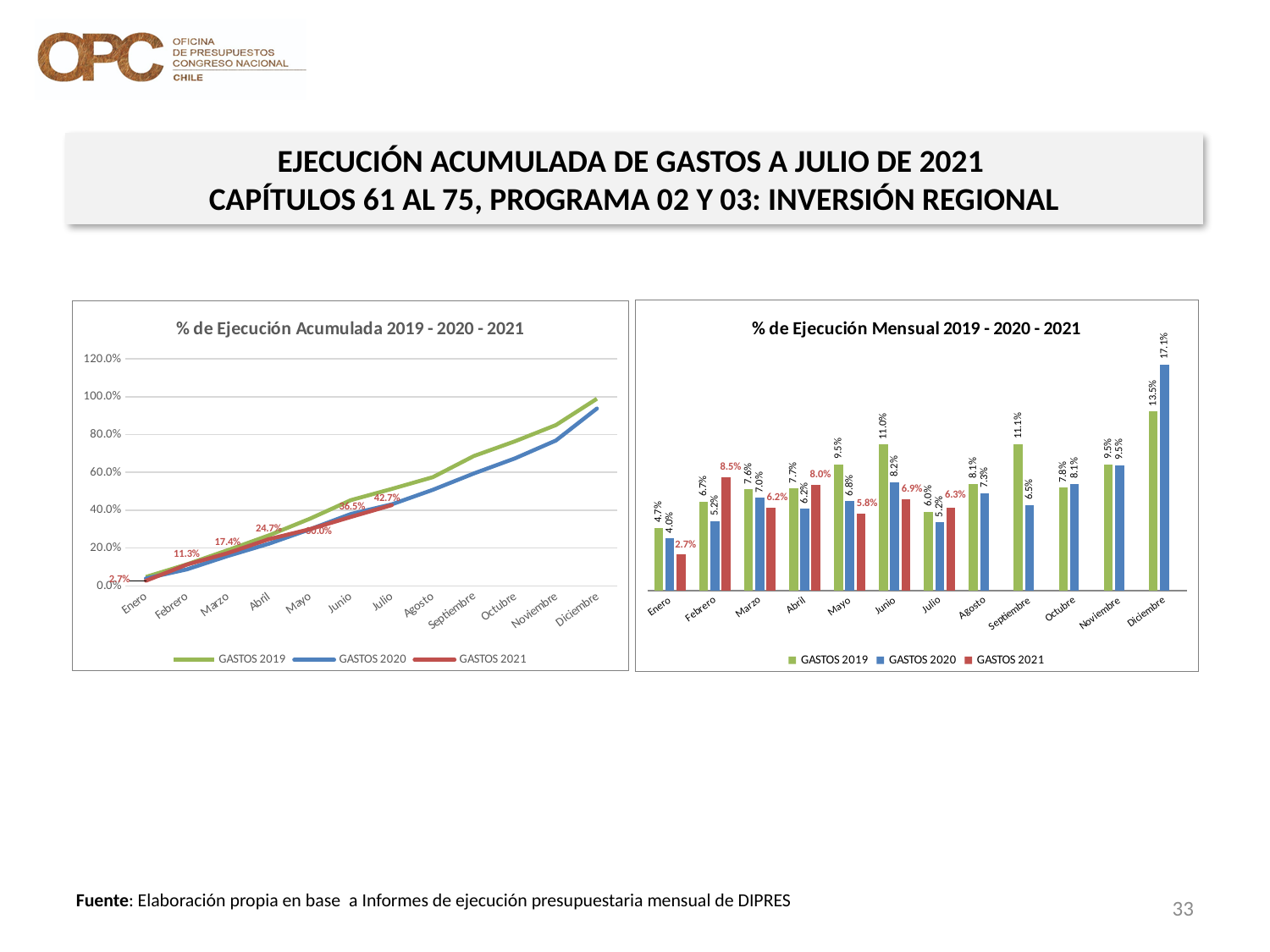
In the '% de Ejecución Acumulada 2019 - 2020 - 2021' chart, what is the value for GASTOS 2021 in Julio? 42.7% In the '% de Ejecución Acumulada 2019 - 2020 - 2021' chart, what kind of chart is shown? Line chart In the '% de Ejecución Acumulada 2019 - 2020 - 2021' chart, is the value for GASTOS 2019 in Diciembre greater or less than 80.0%? greater In the '% de Ejecución Acumulada 2019 - 2020 - 2021' chart, do the GASTOS 2021 values rise or fall from Enero to Julio? rise In the '% de Ejecución Mensual 2019 - 2020 - 2021' chart, what is the value for GASTOS 2020 in Diciembre? 17.1% In the '% de Ejecución Acumulada 2019 - 2020 - 2021' chart, what is the value for GASTOS 2021 in Marzo? 17.4% In the '% de Ejecución Mensual 2019 - 2020 - 2021' chart, which month has the highest value for GASTOS 2021? Febrero In the '% de Ejecución Mensual 2019 - 2020 - 2021' chart, which is larger in Abril: GASTOS 2021 or GASTOS 2020? GASTOS 2021 In the '% de Ejecución Mensual 2019 - 2020 - 2021' chart, which month has the lowest value for GASTOS 2019? Enero In the '% de Ejecución Mensual 2019 - 2020 - 2021' chart, how many months are shown on the x axis? 12 In the '% de Ejecución Acumulada 2019 - 2020 - 2021' chart, how many series does the legend list? 3 In the '% de Ejecución Mensual 2019 - 2020 - 2021' chart, what is the difference between GASTOS 2019 and GASTOS 2020 in Junio? 2.8%